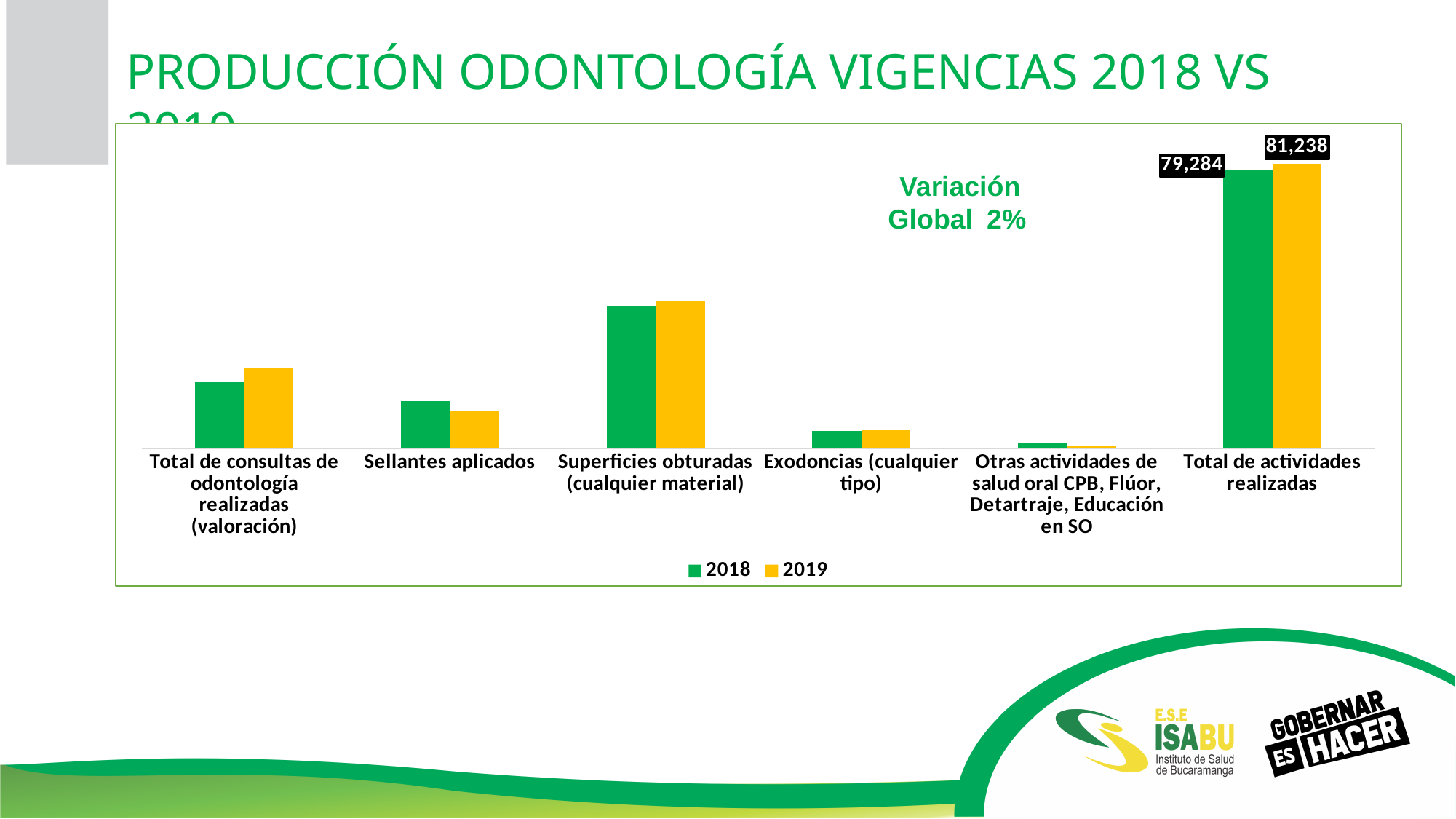
How many categories are shown on the x axis of the chart? 6 For Total de actividades realizadas, which year has the larger value, 2018 or 2019? 2019 For Sellantes aplicados, which year has the larger value, 2018 or 2019? 2018 What is the difference between the 2019 and 2018 values for Total de actividades realizadas? 1,954 What global variation percentage is annotated on the chart? 2% What is the 2019 value for Total de actividades realizadas? 81,238 How many series does the legend list? 2 Which category has the lowest values for both 2018 and 2019? Otras actividades de salud oral CPB, Flúor, Detartraje, Educación en SO What kind of chart is shown on the slide? Bar chart What is the 2018 value for Total de actividades realizadas? 79,284 For Total de consultas de odontología realizadas (valoración), which year has the larger value, 2018 or 2019? 2019 Excluding Total de actividades realizadas, which category has the highest 2019 value? Superficies obturadas (cualquier material)